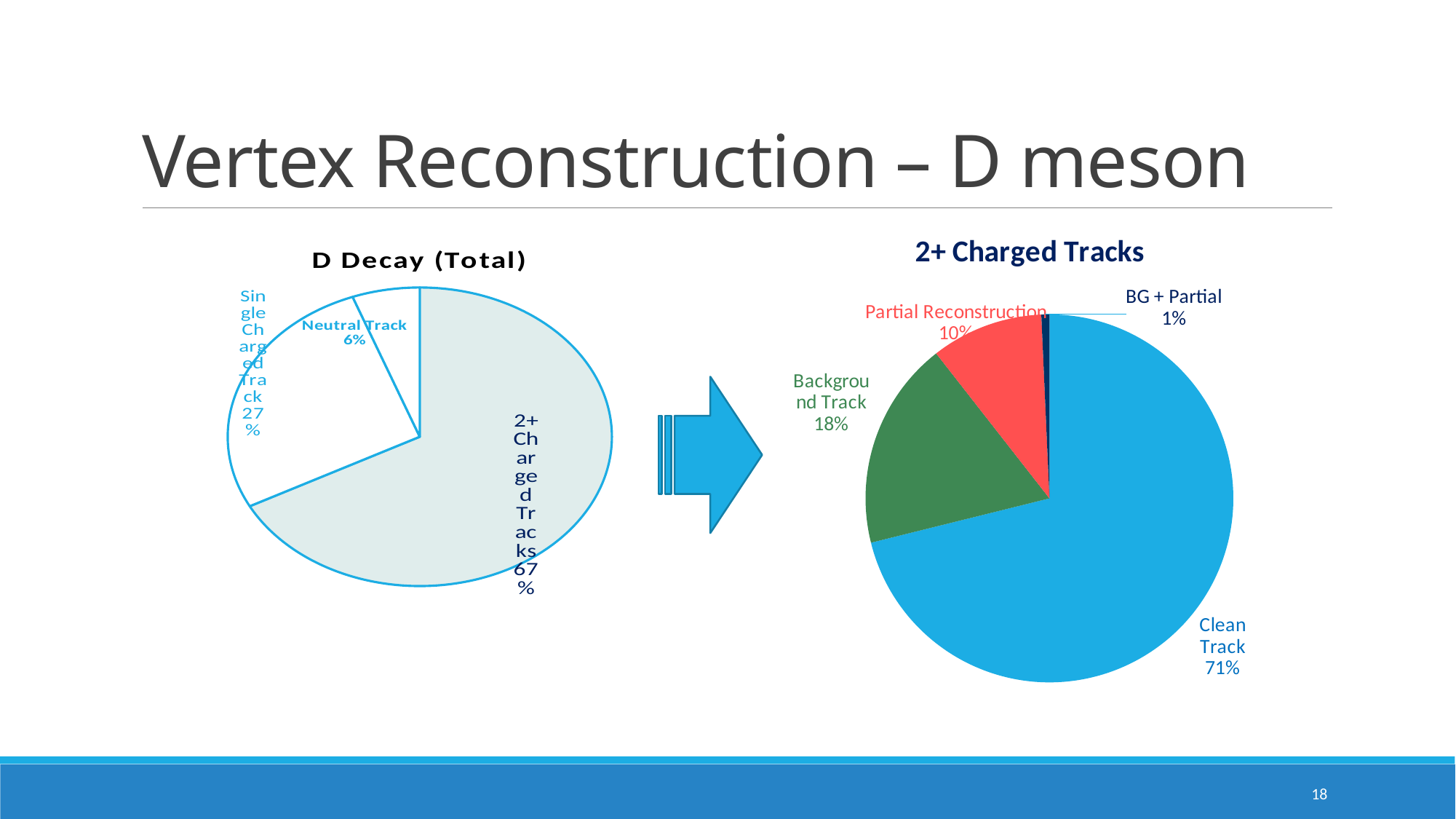
In the 'D Decay (Total)' chart, which slice is the smallest? Neutral Track What kind of chart is the chart on the right of the slide? Pie chart In the '2+ Charged Tracks' chart, what share is labelled for Clean Track? 71% In the 'D Decay (Total)' chart, how many slices does the pie have? 3 In the '2+ Charged Tracks' chart, what share is labelled for Partial Reconstruction? 10% In the '2+ Charged Tracks' chart, what share is labelled for Background Track? 18% In the '2+ Charged Tracks' chart, which slice is the smallest? BG + Partial In the '2+ Charged Tracks' chart, which slice is the largest? Clean Track In the '2+ Charged Tracks' chart, what is the difference in percentage points between Background Track and Partial Reconstruction? 8